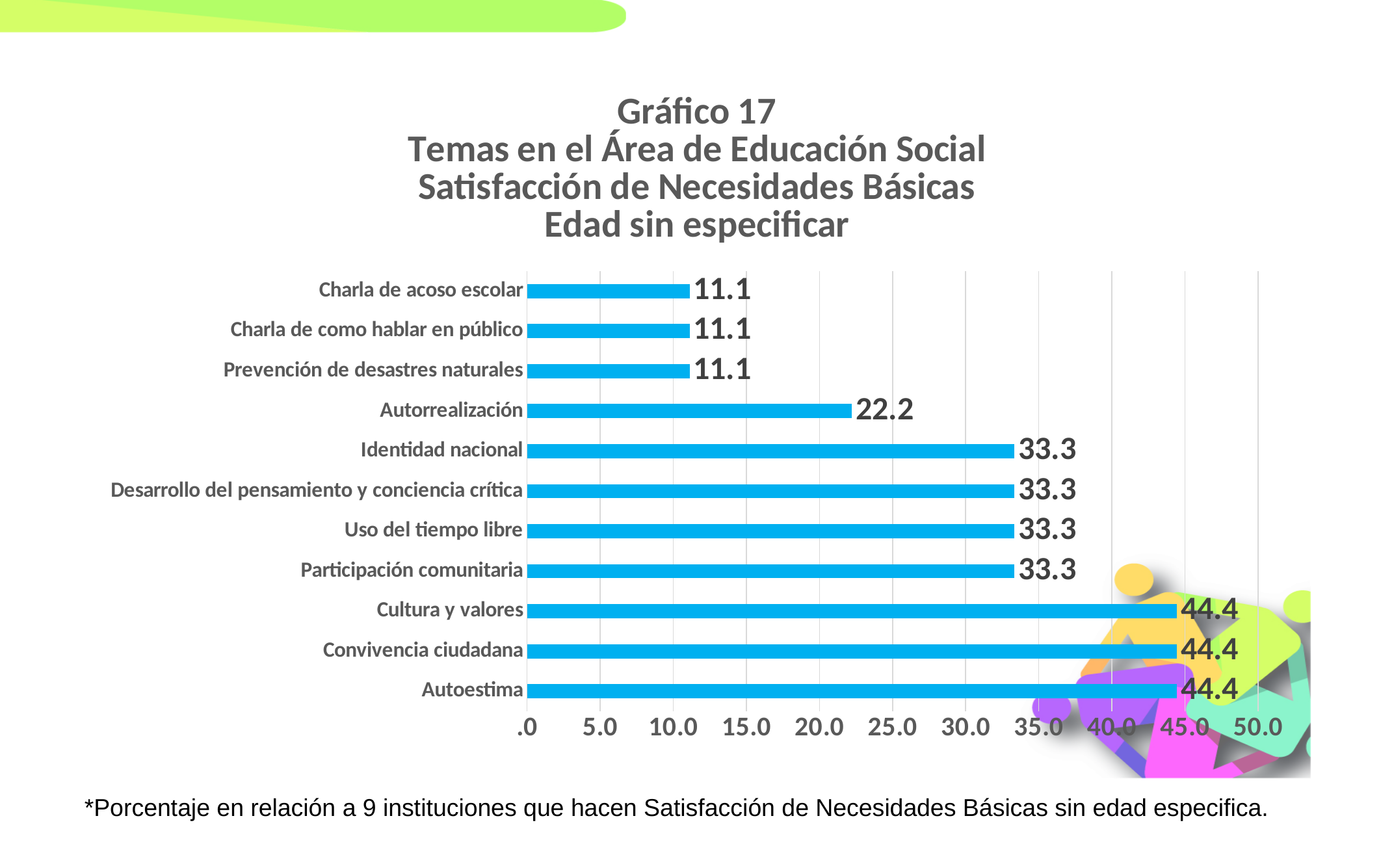
Which is larger, the value for Cultura y valores or the value for Participación comunitaria? Cultura y valores What is the value for Autorrealización? 22.2 Is the value for Autorrealización greater or less than 20.0? greater What is the highest value shown in the chart? 44.4 How many categories are shown in the chart? 11 What is the value for Charla de acoso escolar? 11.1 What is the difference between the values for Autoestima and Autorrealización? 22.2 What is the value for Identidad nacional? 33.3 What is the number of the chart given in its title? Gráfico 17 What is the difference between the values for Uso del tiempo libre and Prevención de desastres naturales? 22.2 What kind of chart is shown on the slide? bar chart What is the value for Convivencia ciudadana? 44.4